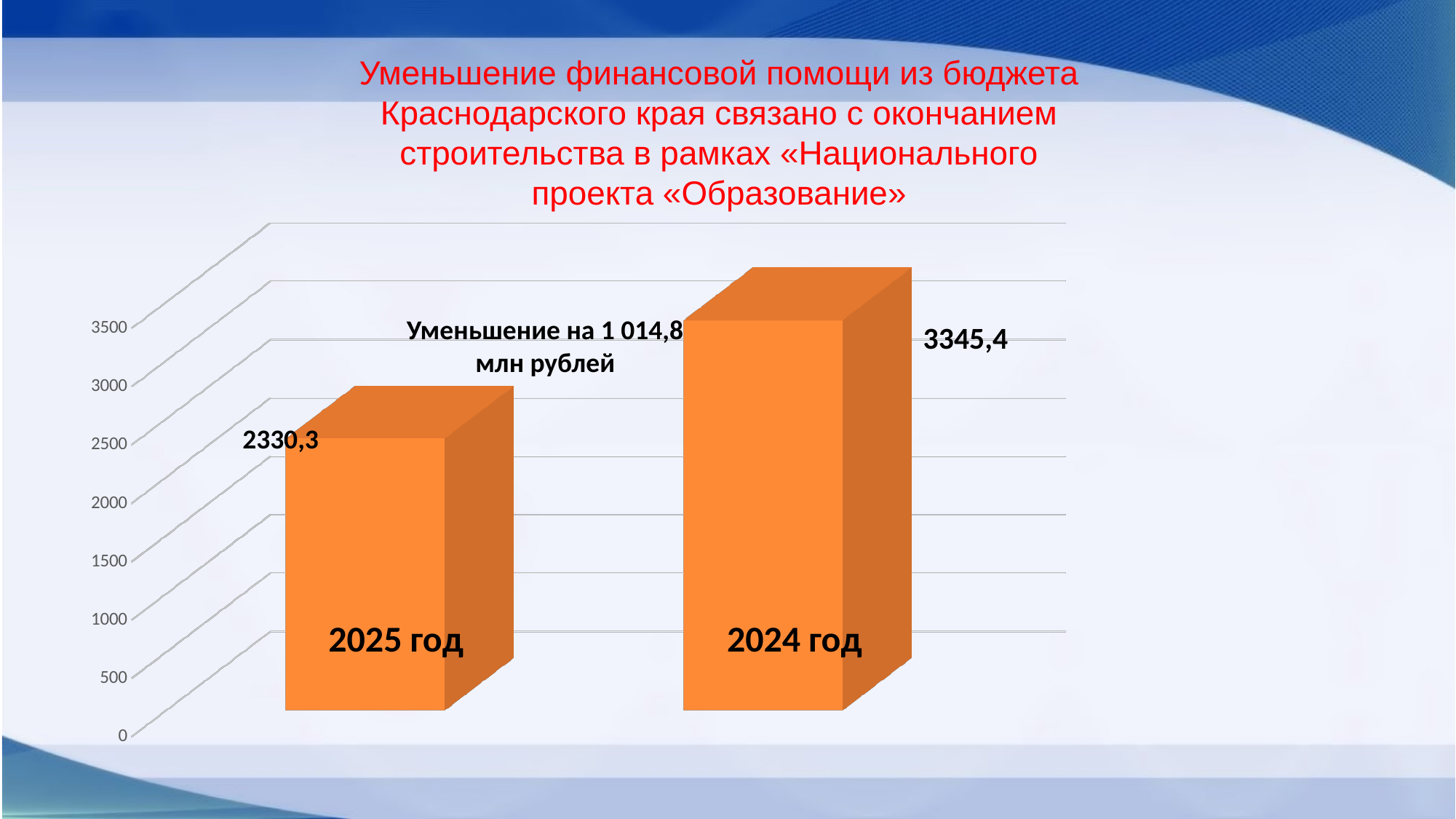
What is the value shown for 2024 год? 3345,4 Which year has the higher value, 2024 год or 2025 год? 2024 год Is the value for 2024 год greater or less than 3000? greater Do the values rise or fall moving from the left bar (2025 год) to the right bar (2024 год)? rise What is the value shown for 2025 год? 2330,3 Which category has the highest value on the chart? 2024 год What kind of chart is shown on the slide? bar chart What is the highest tick value shown on the vertical axis? 3500 According to the annotation on the chart, by how much did the financial aid decrease? 1 014,8 млн рублей Is the value for 2025 год greater or less than 2500? less Which category has the lowest value on the chart? 2025 год How many bars are plotted on the chart? 2